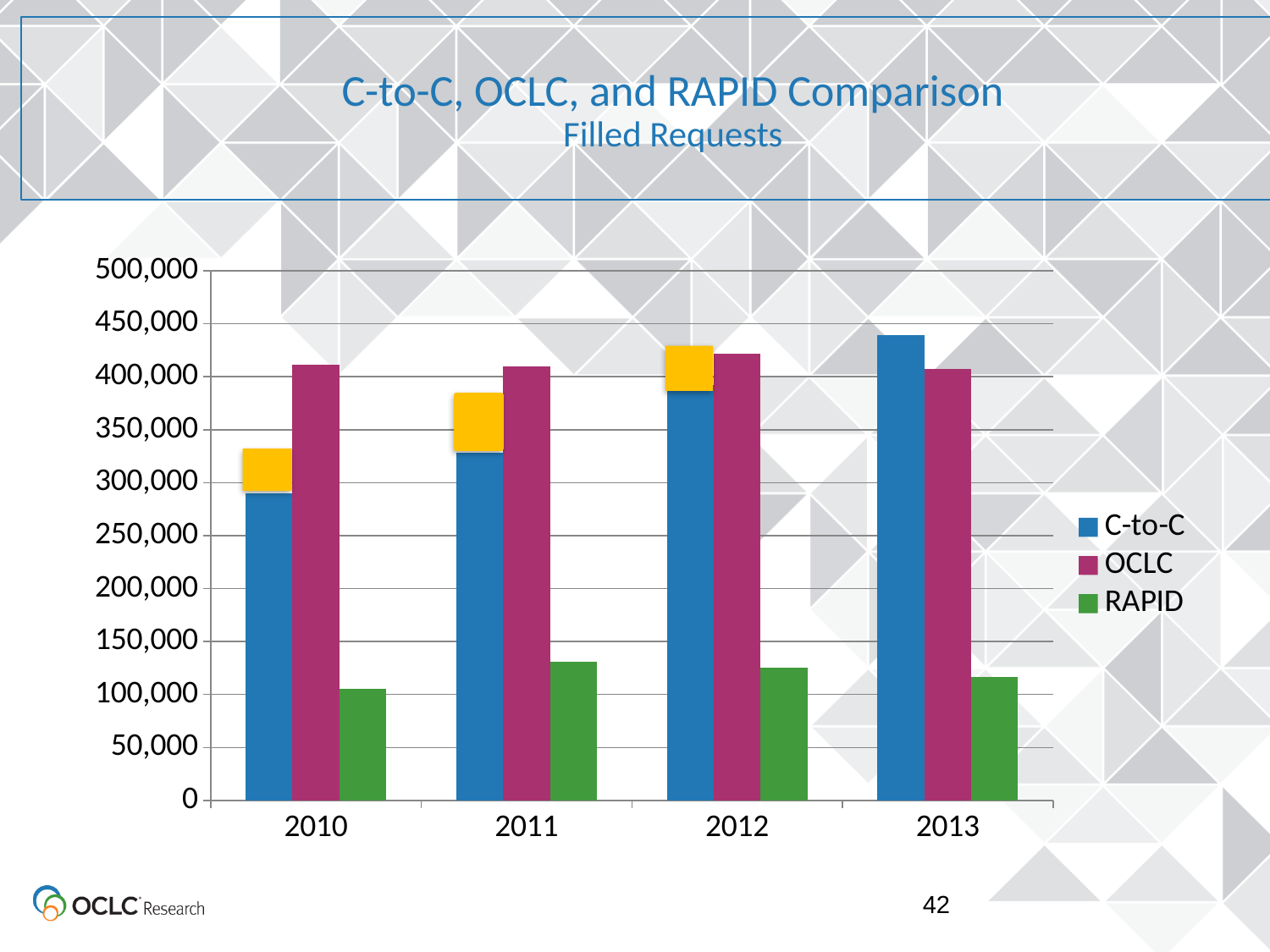
Do the C-to-C values rise or fall from 2010 to 2013? rise Is the value for C-to-C in 2010 greater or less than 300,000? less How many years are shown on the x axis? 4 In which year is the C-to-C value highest? 2013 Is the value for C-to-C in 2013 greater or less than 400,000? greater Is the value for OCLC in 2012 greater or less than 400,000? greater What kind of chart is shown on the slide? bar chart How many series does the legend list? 3 In 2010, which is larger, C-to-C or OCLC? OCLC Which series has the lowest value in every year shown? RAPID In 2013, which is larger, C-to-C or OCLC? C-to-C